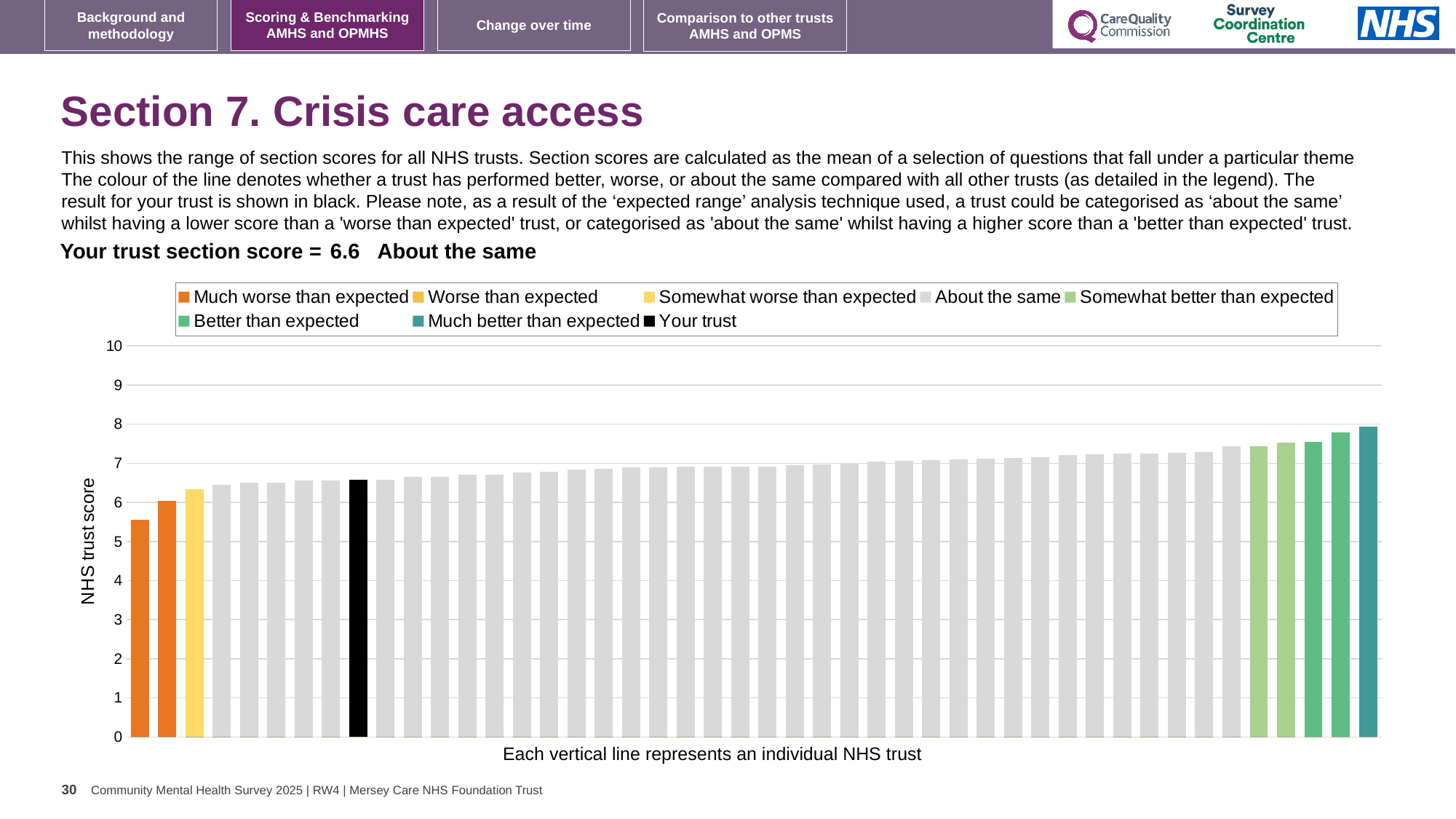
What is the label on the vertical axis of the chart? NHS trust score Which legend category does the shortest bar in the chart belong to? Much worse than expected Do the bar values rise or fall from left to right along the x axis? rise What is the section score for your trust shown on the slide? 6.6 Is the value of the black 'Your trust' bar greater or less than 6? greater Which legend category does the tallest bar in the chart belong to? Much better than expected What is the label below the horizontal axis of the chart? Each vertical line represents an individual NHS trust How many entries does the chart legend list? 8 What kind of chart is shown on the slide? bar chart Is the value of the tallest bar greater or less than 7? greater Is the value of the shortest bar greater or less than 6? less How many bars are coloured as 'Much worse than expected' (orange)? 2